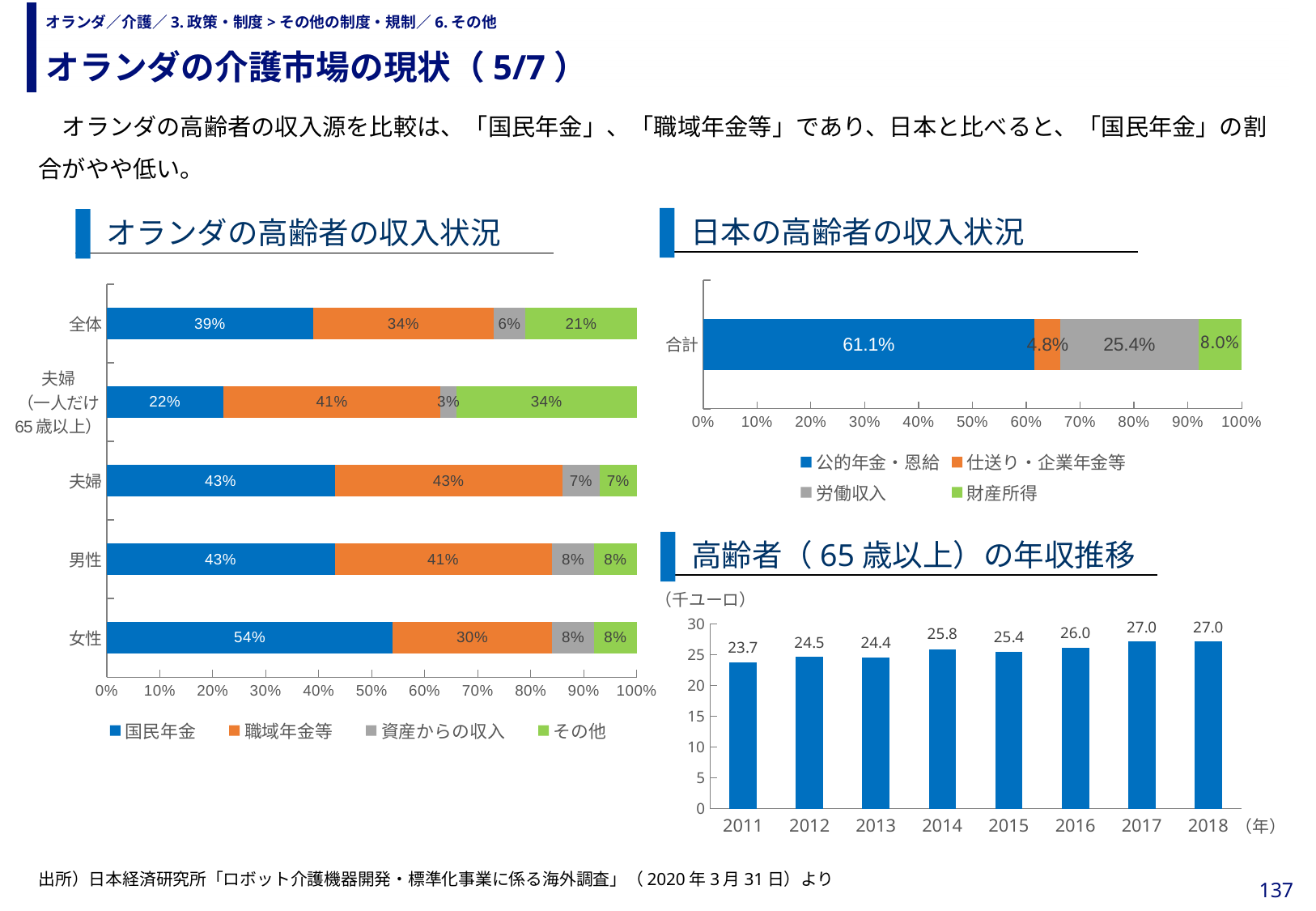
In the chart titled オランダの高齢者の収入状況, how many series does the legend list? 4 In the chart titled 高齢者（65歳以上）の年収推移, which year has the lowest value? 2011 In the chart titled 高齢者（65歳以上）の年収推移, what is the difference between the 2018 value and the 2011 value? 3.3 In the chart titled 高齢者（65歳以上）の年収推移, how many years are plotted? 8 In the chart titled 日本の高齢者の収入状況, what is the share for 公的年金・恩給? 61.1% In the chart titled オランダの高齢者の収入状況, which category has the lowest 国民年金 share? 夫婦（一人だけ65歳以上） In the chart titled オランダの高齢者の収入状況, which has the larger 職域年金等 share, 男性 or 女性? 男性 In the chart titled 高齢者（65歳以上）の年収推移, what is the value for 2011? 23.7 In the chart titled オランダの高齢者の収入状況, what is the 国民年金 share for 女性? 54% In the chart titled オランダの高齢者の収入状況, what is the その他 share for 全体? 21% In the chart titled オランダの高齢者の収入状況, which category has the highest 国民年金 share? 女性 In the chart titled 日本の高齢者の収入状況, how much larger is the 労働収入 share than the 仕送り・企業年金等 share? 20.6 percentage points